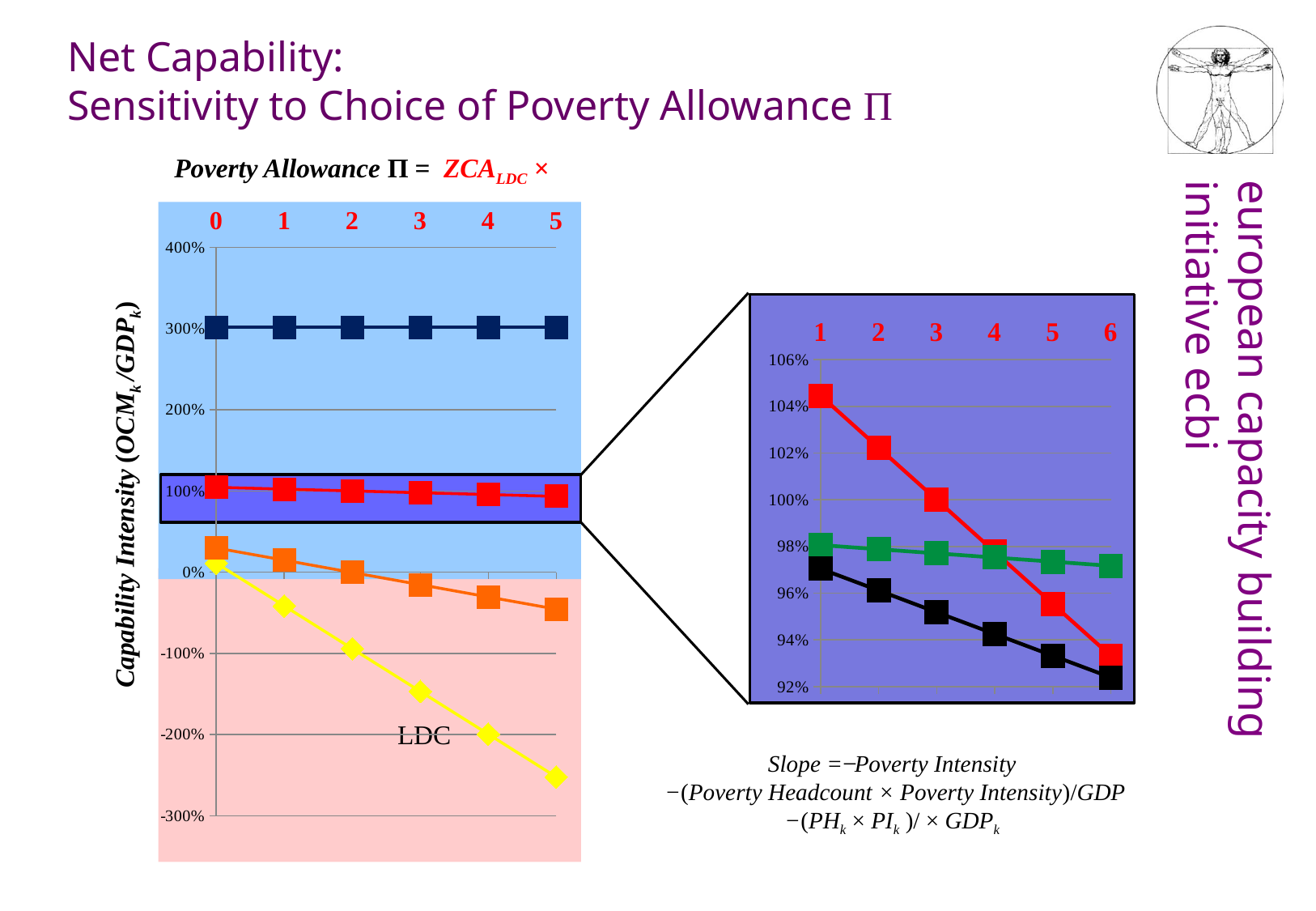
In the inset chart on the right, is the value of the red series at point 1 greater or less than 104%? greater In the main chart on the left, how many x-axis points (multiplier values) are plotted? 6 In the main chart on the left, which coloured series has the highest values? dark blue In the main chart on the left, is the value of the yellow series at multiplier 5 greater or less than -200%? less What is the y-axis label of the main chart on the left? Capability Intensity (OCMk/GDPk) In the main chart on the left, is the value of the orange series at multiplier 5 greater or less than 0%? less What kind of chart is the main chart on the left of the slide? line chart In the main chart on the left, does the yellow series rise or fall as the multiplier increases from 0 to 5? fall In the main chart on the left, how does the dark blue series change as the multiplier increases from 0 to 5? It stays flat In the inset chart on the right, at point 6, which is larger: the green series or the black series? green